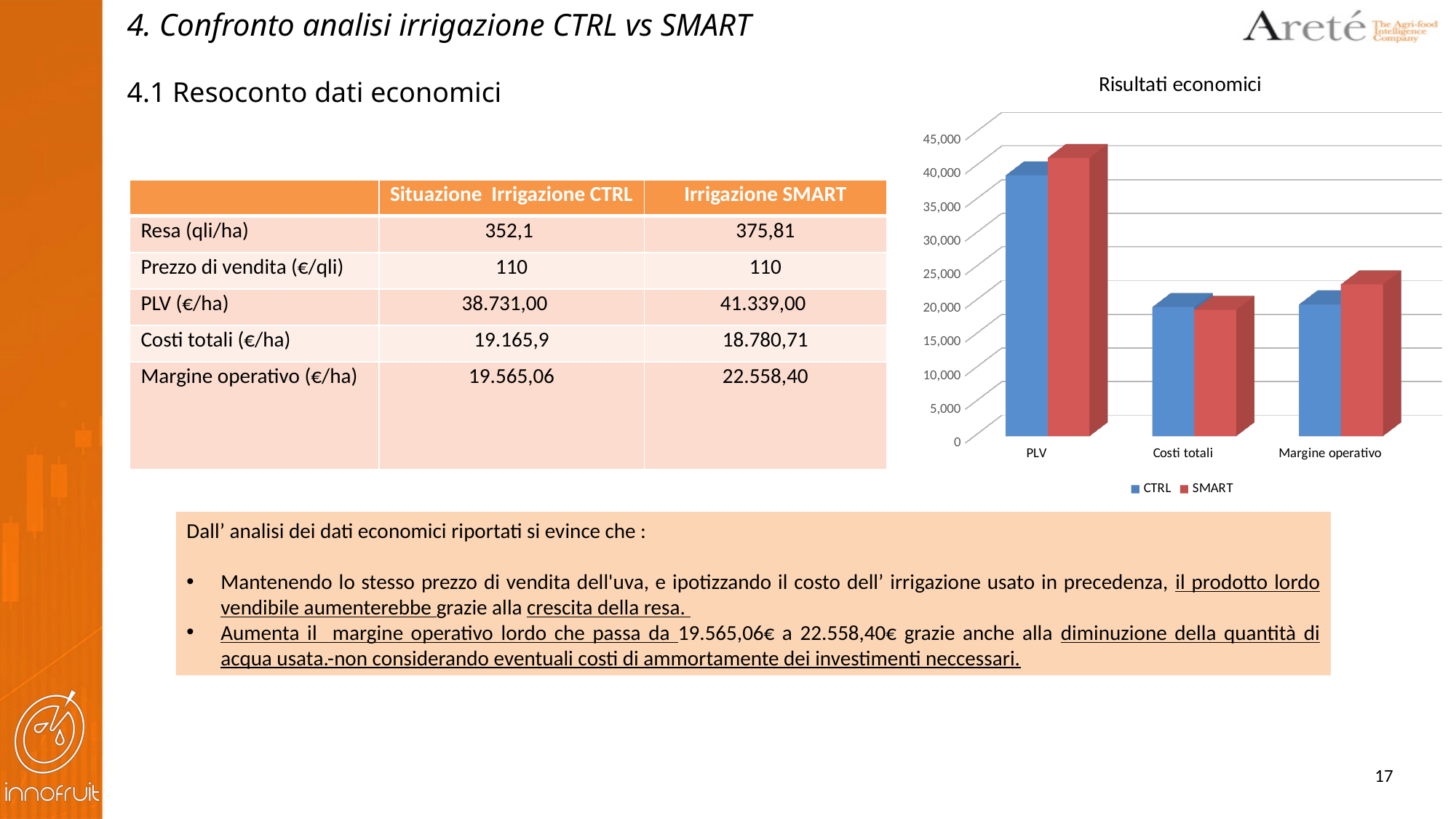
In the "Risultati economici" chart, is the Margine operativo value for SMART greater or less than 20,000? greater In the "Risultati economici" chart, which series has the larger Margine operativo value, CTRL or SMART? SMART What kind of chart is shown under the title "Risultati economici"? bar chart Which series in the "Risultati economici" chart is drawn in red? SMART In the "Risultati economici" chart, is the PLV value for CTRL greater or less than 35,000? greater In the "Risultati economici" chart, is the Costi totali value for CTRL greater or less than 20,000? less In the "Risultati economici" chart, which category has the lowest SMART value? Costi totali How many series does the legend of the "Risultati economici" chart list? 2 In the "Risultati economici" chart, which series has the larger PLV value, CTRL or SMART? SMART In the "Risultati economici" chart, which category has the highest CTRL value? PLV How many categories are shown on the x axis of the "Risultati economici" chart? 3